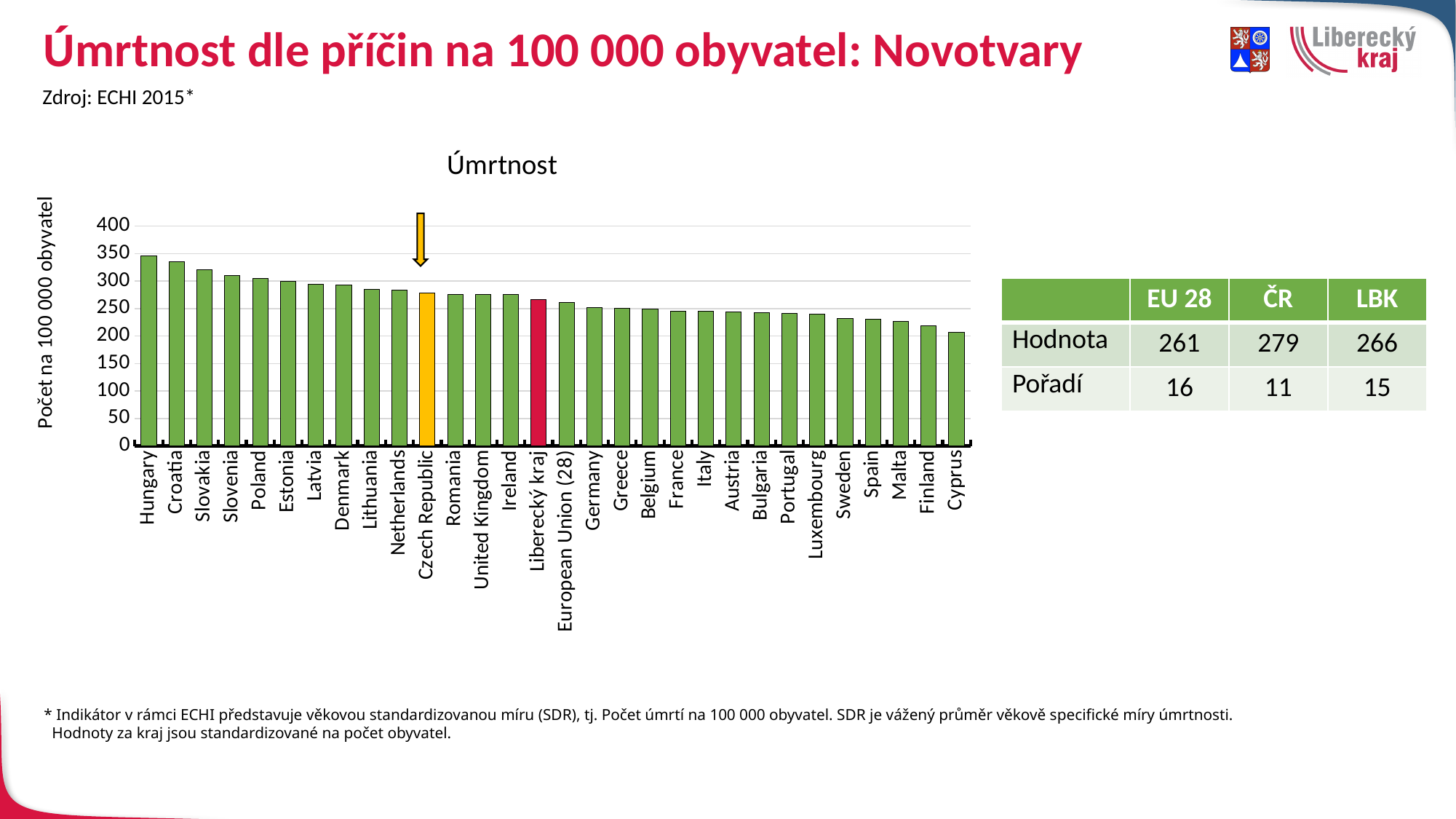
What is the difference between the values for Czech Republic (ČR) and Liberecký kraj (LBK)? 13 What is the value for Liberecký kraj, as given in the table (LBK)? 266 Is the value for Hungary greater or less than 300? greater What is the value for European Union (28), as given in the table (EU 28)? 261 How many categories (bars) are plotted in the chart? 30 Do the values rise or fall moving from left to right along the x axis? fall What kind of chart is shown on the slide? bar chart What is the value for Czech Republic, as given in the table (ČR)? 279 Which country has the highest value in the chart? Hungary Which country has the lowest value in the chart? Cyprus What is the title of the chart? Úmrtnost Is the value for Finland greater or less than 250? less